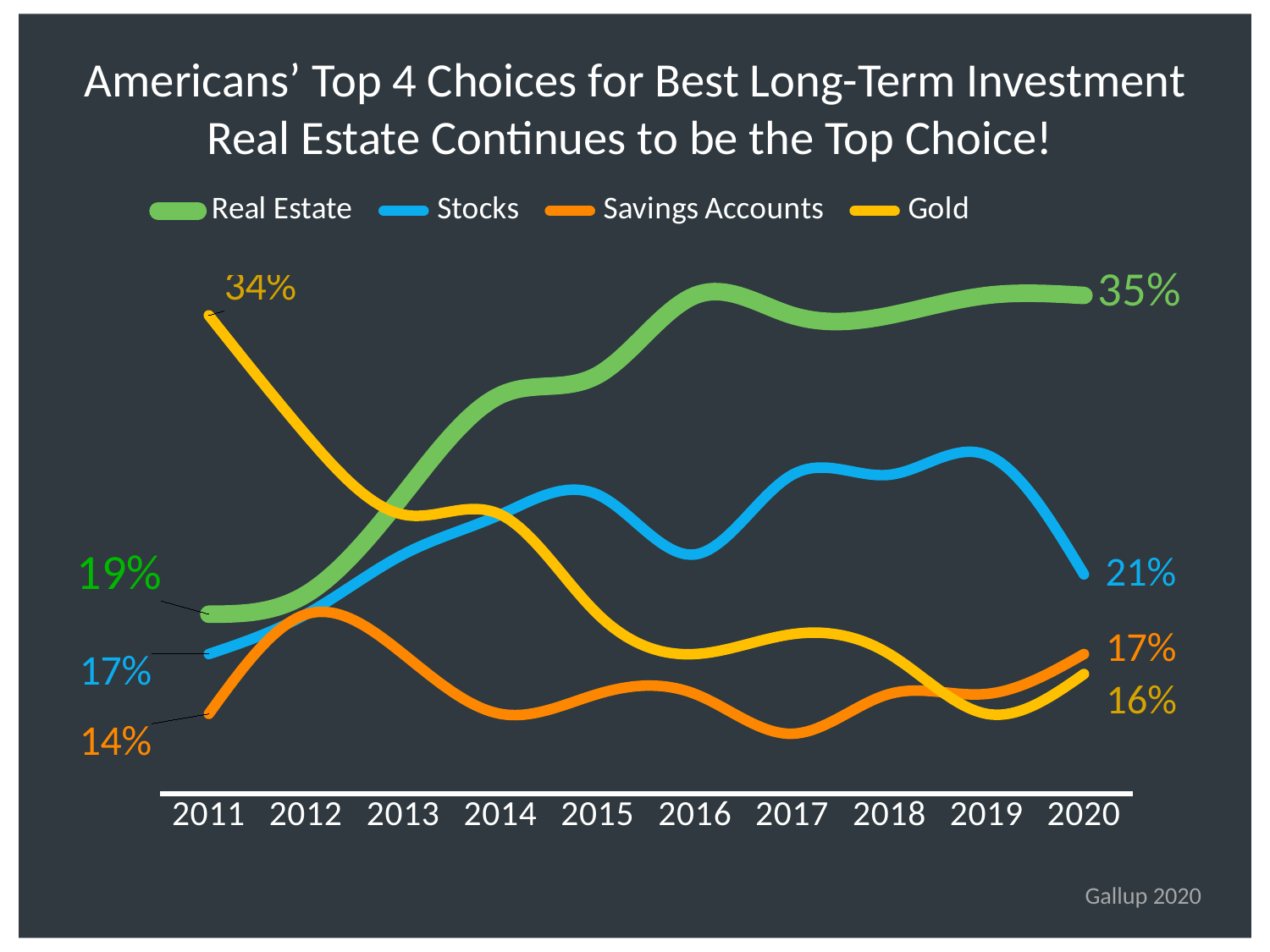
What is the value for Real Estate in 2020? 35% What is the value for Gold in 2011? 34% Which series has the highest value in 2011? Gold What is the value for Stocks in 2020? 21% How many years are shown on the x axis? 10 What is the difference between the Real Estate value in 2020 and its value in 2011? 16% What kind of chart is shown on the slide? line chart Does the Gold line rise or fall from 2011 to 2020? fall How many series does the legend list? 4 What is the value for Savings Accounts in 2011? 14% Which is larger in 2020, the value for Savings Accounts or the value for Gold? Savings Accounts Which series has the lowest value in 2020? Gold